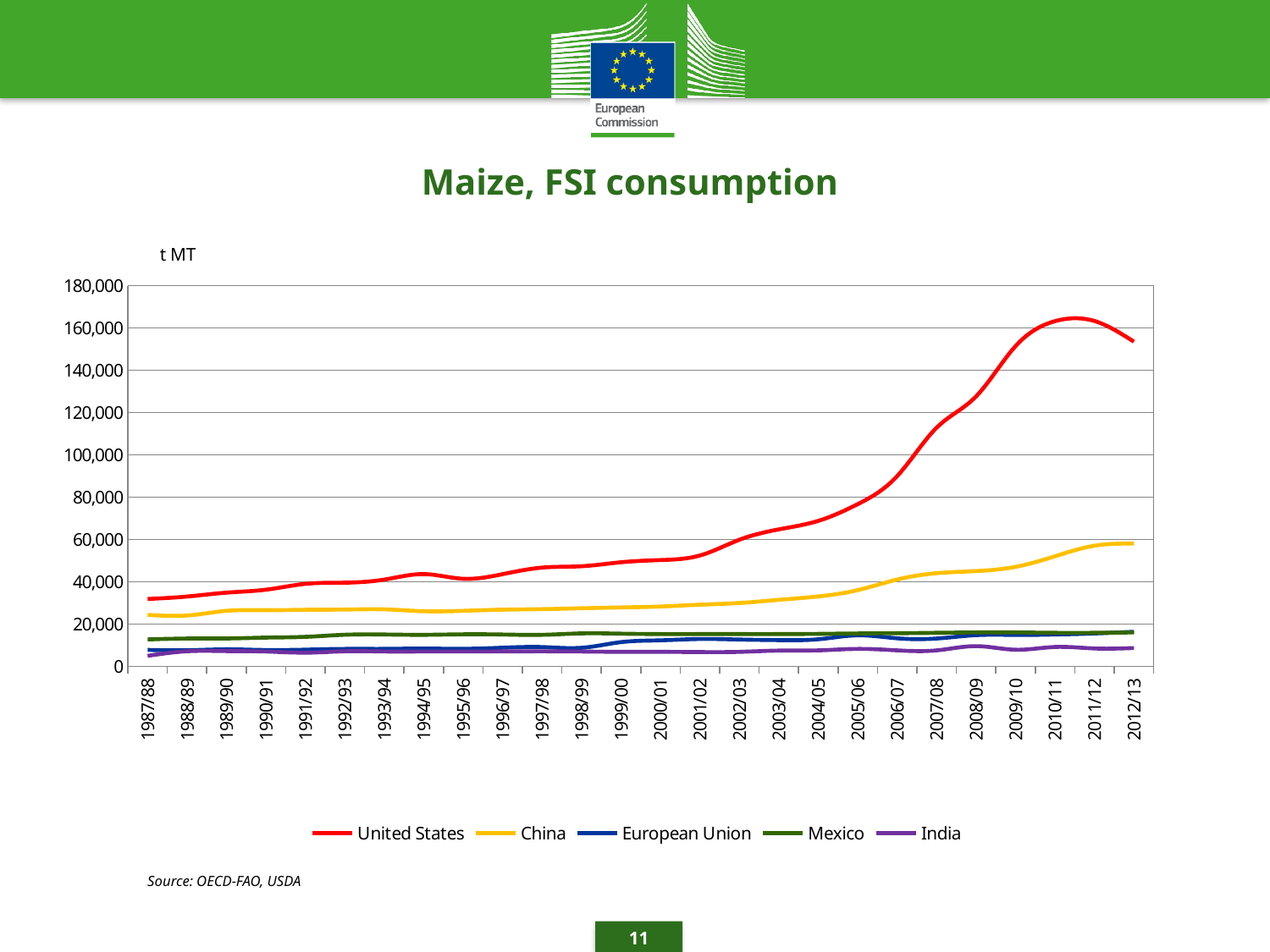
Which country or region has the lowest maize FSI consumption in 2012/13? India Which country or region has the highest maize FSI consumption in 2012/13? United States Which is larger in 2012/13, the value for the European Union or the value for India? European Union What unit is shown on the y axis of the chart? t MT How many marketing years are shown along the x axis? 26 Is the value for China in 2012/13 greater or less than 40,000? greater Does the United States line rise or fall between 1987/88 and 2010/11? Rise What kind of chart is shown on the slide? Line chart Is the value for the United States in 2010/11 greater or less than 140,000? greater Is the value for India in 2012/13 greater or less than 20,000? less How many series does the legend list? 5